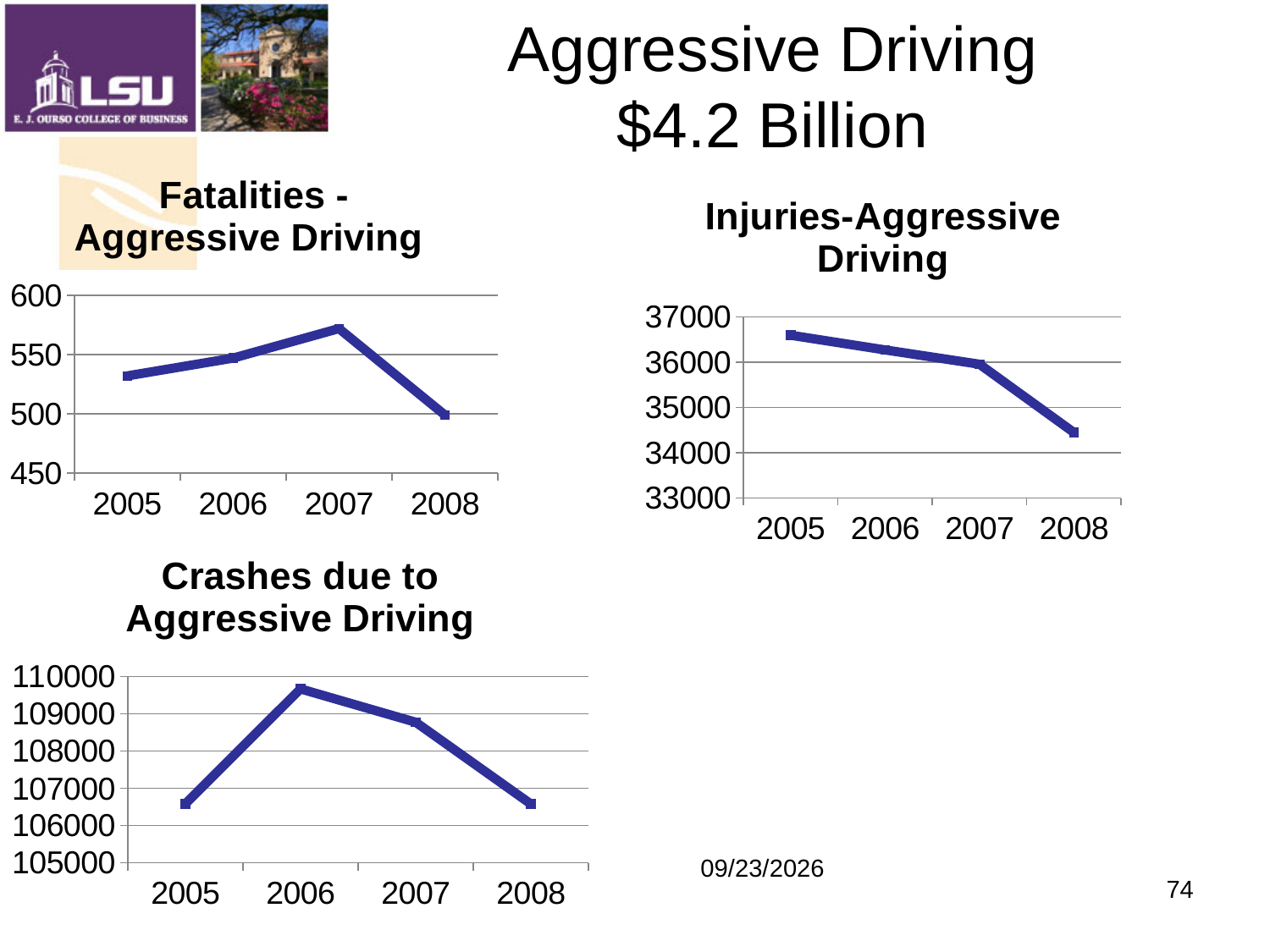
How many years are plotted on the "Injuries-Aggressive Driving" chart? 4 In the "Fatalities - Aggressive Driving" chart, which year has the highest value? 2007 What kind of chart is the "Fatalities - Aggressive Driving" chart? line chart In the "Injuries-Aggressive Driving" chart, which year has the highest value? 2005 In the "Crashes due to Aggressive Driving" chart, is the value for 2006 greater or less than 109000? greater In the "Fatalities - Aggressive Driving" chart, is the value for 2007 greater or less than 550? greater In the "Crashes due to Aggressive Driving" chart, which year has the highest value? 2006 In the "Injuries-Aggressive Driving" chart, is the value for 2008 greater or less than 35000? less In the "Injuries-Aggressive Driving" chart, do the values rise or fall from 2005 to 2008? fall In the "Crashes due to Aggressive Driving" chart, which is larger, the value for 2006 or the value for 2007? 2006 In the "Fatalities - Aggressive Driving" chart, which year has the lowest value? 2008